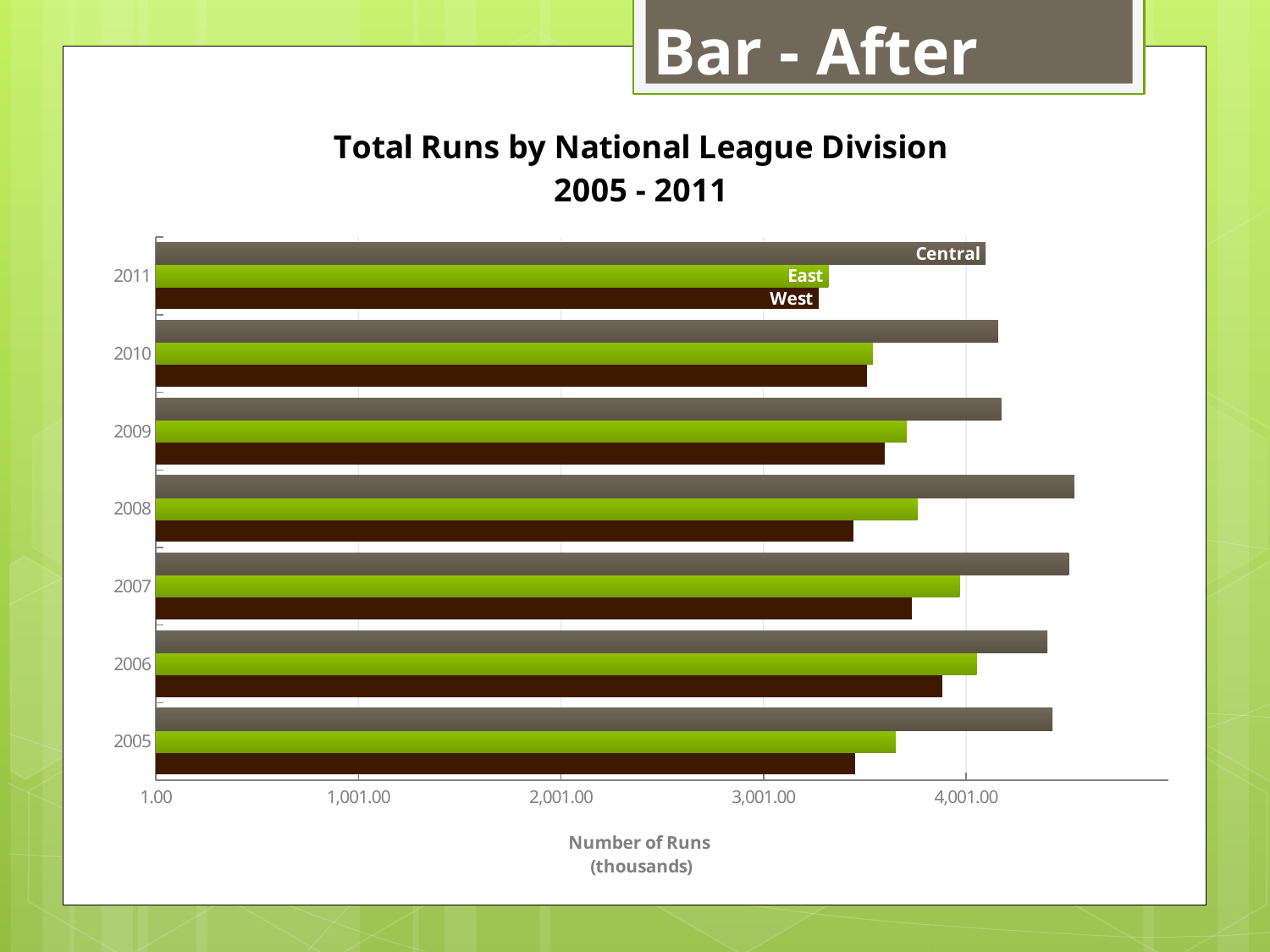
How many years are shown on the vertical axis of the chart? 7 Which division has the highest value in 2011? Central Which is larger, the East value in 2006 or the East value in 2005? East in 2006 Which division has the lowest value in 2008? West Which is larger, the Central value in 2008 or the Central value in 2011? Central in 2008 What is the label on the horizontal axis of the chart? Number of Runs (thousands) What kind of chart is shown on the slide? bar chart Is the value for Central in 2008 greater or less than 4,001.00? greater How many divisions (series) are plotted in the chart? 3 What is the title of the chart? Total Runs by National League Division 2005 - 2011 Which division has the lowest value in 2007? West Is the value for West in 2008 greater or less than 3,001.00? greater